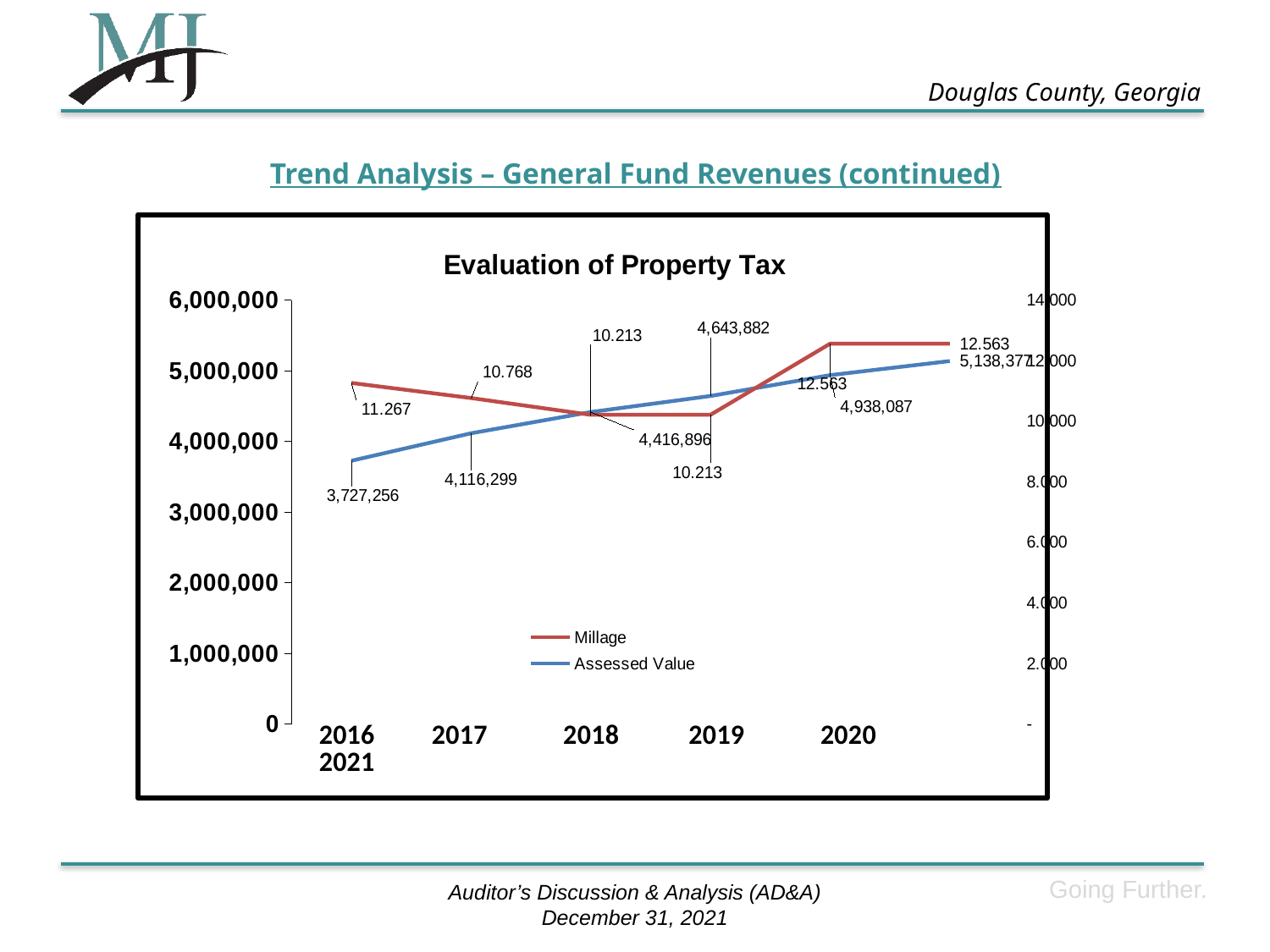
What is the Assessed Value for 2016? 3,727,256 Is the Assessed Value for 2021 greater or less than 5,000,000? greater How many series does the legend of the "Evaluation of Property Tax" chart list? 2 In which year is the Assessed Value lowest? 2016 Which year has the higher Millage, 2016 or 2017? 2016 How many years are shown on the x axis of the "Evaluation of Property Tax" chart? 6 What is the Assessed Value for 2019? 4,643,882 By how much did the Assessed Value increase from 2016 to 2017? 389,043 Does the Assessed Value rise or fall from 2016 to 2021? rise What kind of chart is "Evaluation of Property Tax"? line chart What is the Millage value for 2016? 11.267 What is the Millage value for 2020? 12.563